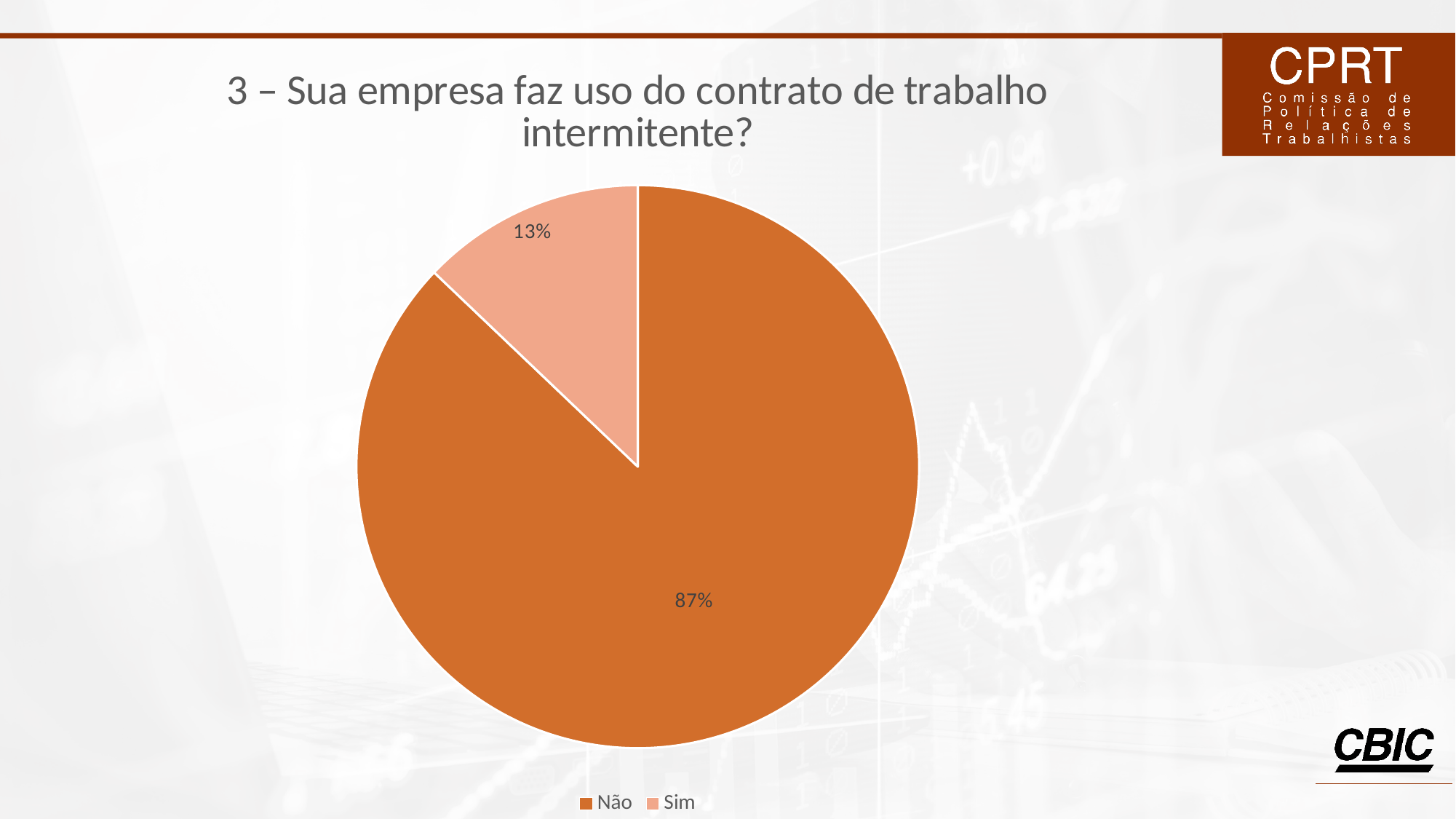
Which category has the smallest slice of the pie? Sim Which is larger, the "Sim" slice or the "Não" slice? Não Which category has the largest slice of the pie? Não What share of the pie does "Não" represent? 87% How many categories does the pie chart show? 2 What is the title of the chart? 3 – Sua empresa faz uso do contrato de trabalho intermitente? What share of the pie does "Sim" represent? 13% How many entries does the legend list? 2 What is the difference in percentage points between the "Não" and "Sim" slices? 74 What kind of chart is shown on the slide? pie chart Which category is shown in the lighter orange colour? Sim